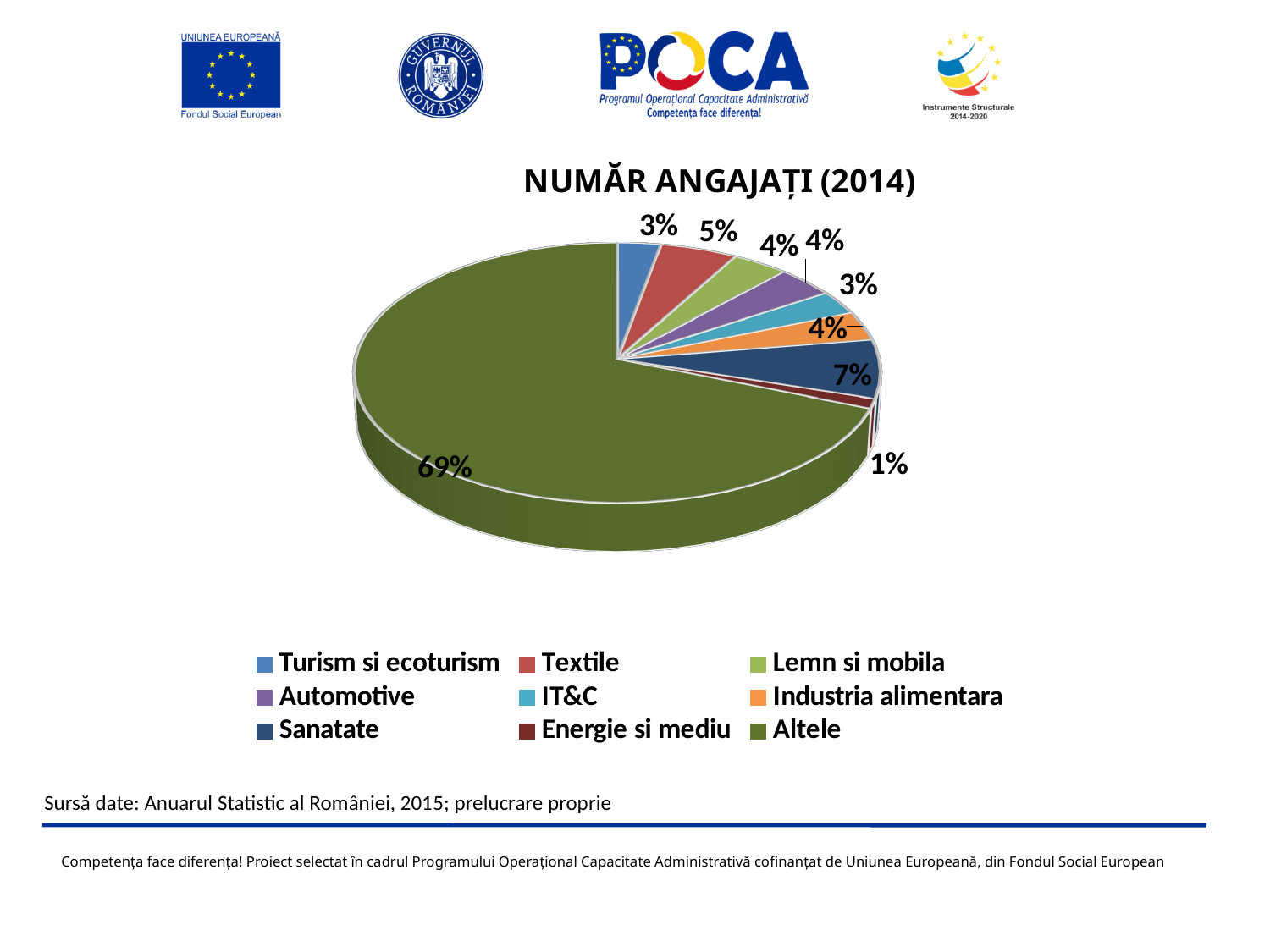
What is the value shown for Energie si mediu? 1% What is the difference in percentage points between Sanatate and Energie si mediu? 6 percentage points What is the title of the chart? NUMĂR ANGAJAȚI (2014) How many categories does the pie chart show? 9 What kind of chart is shown on the slide? Pie chart Which category has the smallest slice of the pie? Energie si mediu Which is larger, the share for Textile or the share for Turism si ecoturism? Textile What is the value shown for Sanatate? 7% Which category has the largest slice of the pie? Altele What share of the pie does Altele represent? 69% What is the difference in percentage points between Altele and Sanatate? 62 percentage points What is the value shown for Textile? 5%